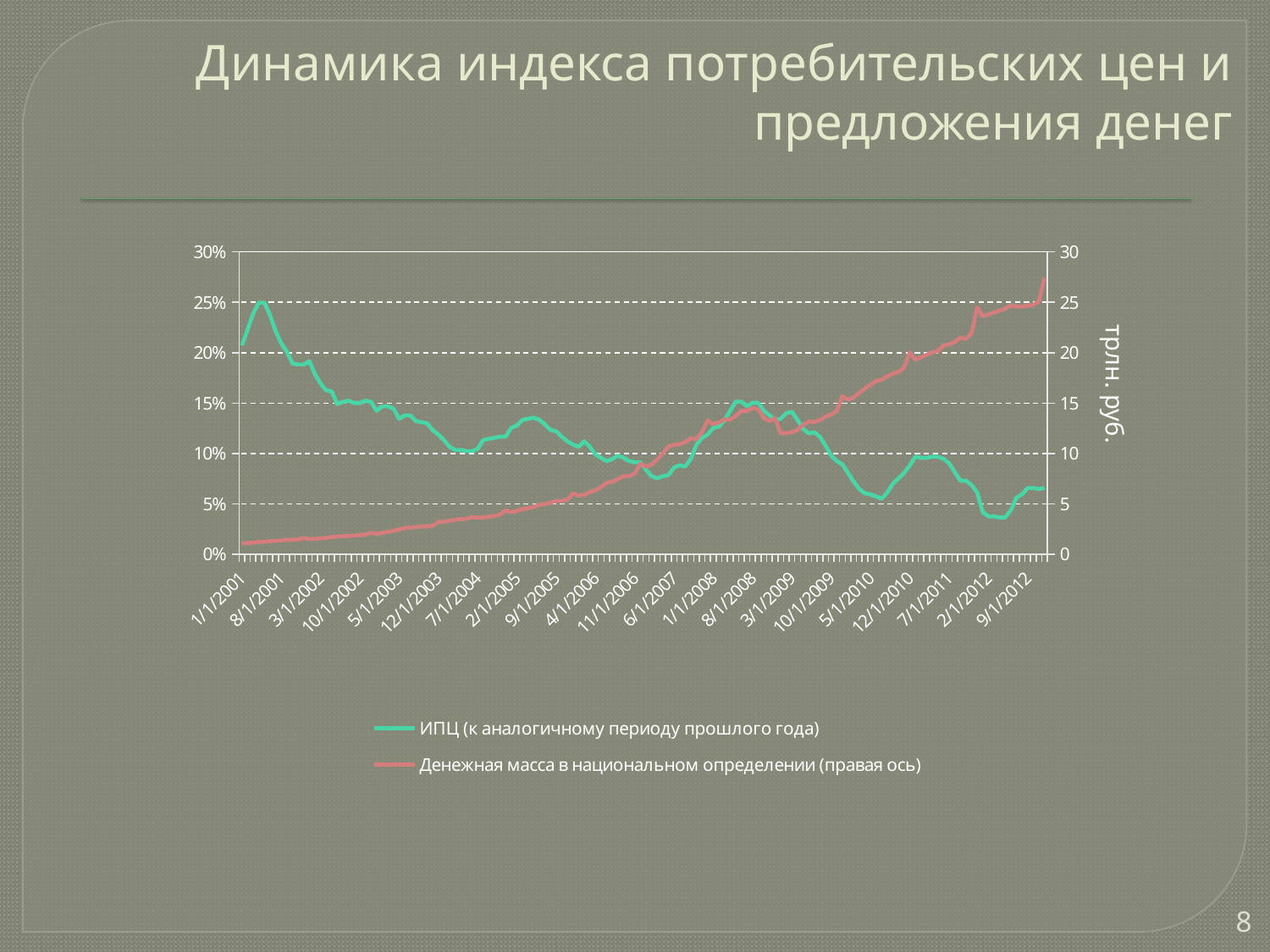
Does the ИПЦ series rise or fall overall from 1/1/2001 to 9/1/2012? fall Is the money supply (Денежная масса) value at 9/1/2012 greater or less than 20? greater Is the ИПЦ value at 1/1/2001 greater or less than 15%? greater Is the ИПЦ value at 2/1/2012 greater or less than 10%? less What is the unit label shown on the right axis? трлн. руб. How many series does the legend list? 2 What kind of chart is shown on the slide? line chart Which series is plotted against the right axis according to the legend? Денежная масса в национальном определении (правая ось) Does the money supply (Денежная масса) series rise or fall overall from 1/1/2001 to 9/1/2012? rise